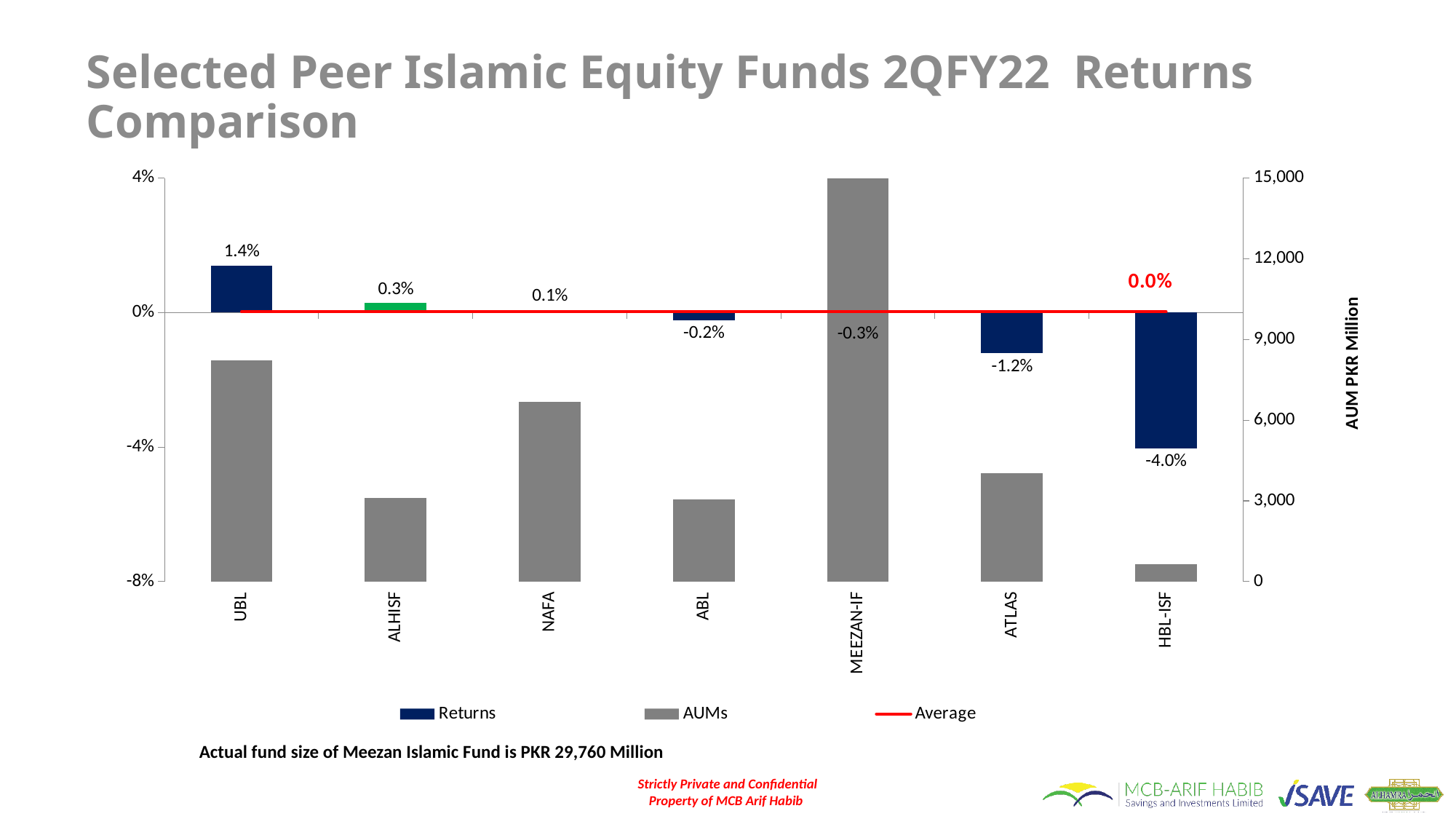
What is the return shown for UBL? 1.4% Is the AUM value for UBL greater or less than 6,000? greater Is the AUM value for HBL-ISF greater or less than 3,000? less Which fund has the lowest return? HBL-ISF How many funds are shown on the x axis? 7 What is the return shown for HBL-ISF? -4.0% What is the return shown for ATLAS? -1.2% What is the difference between the returns of UBL and ALHISF? 1.1% Which fund has the highest return? UBL Which fund has the largest AUM bar? MEEZAN-IF Which has the larger return, ABL or ATLAS? ABL How many series does the legend list? 3